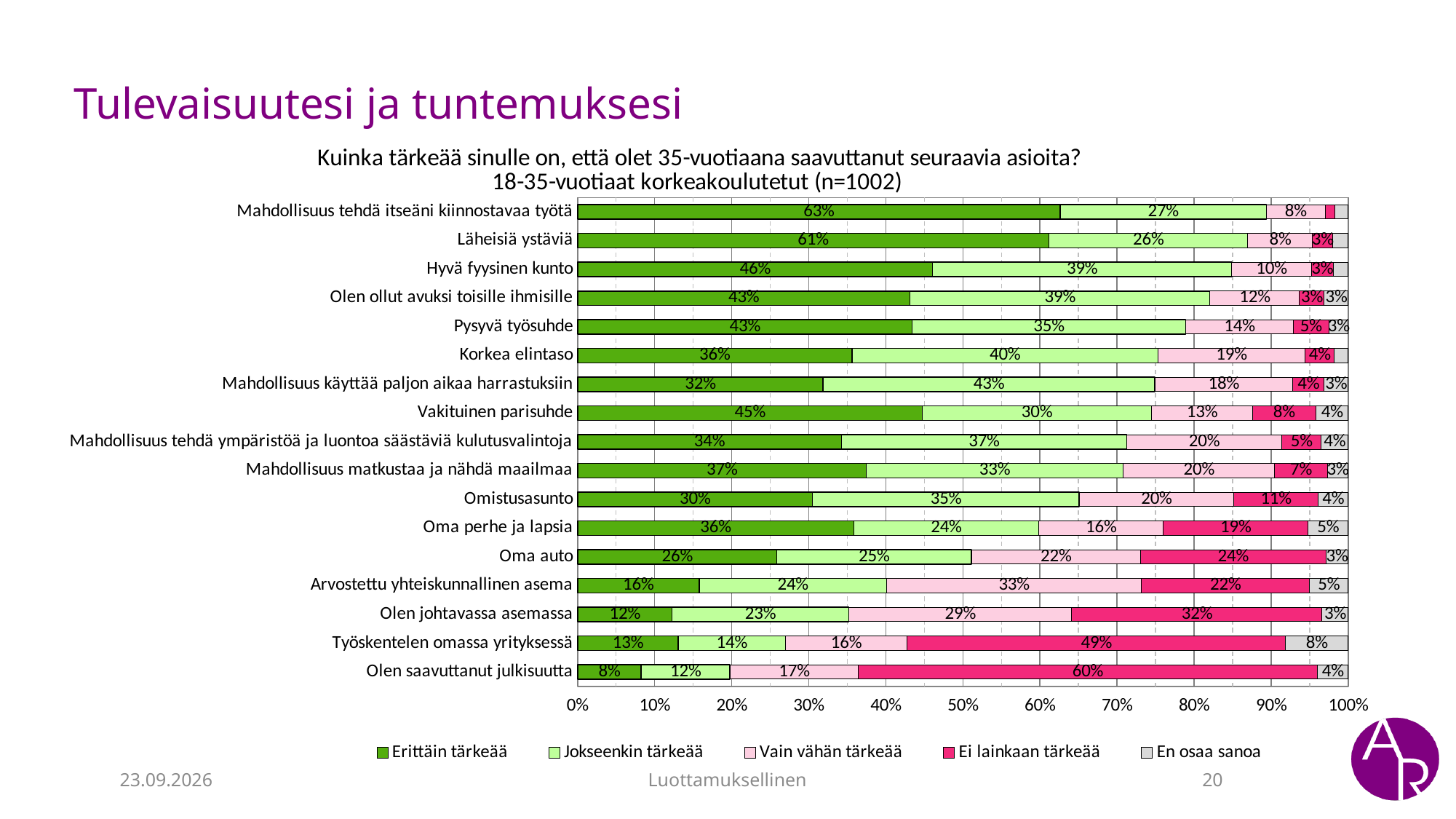
What is the sample size (n) stated in the chart title? n=1002 What is the 'En osaa sanoa' value for 'Työskentelen omassa yrityksessä'? 8% What is the 'Erittäin tärkeää' value for 'Mahdollisuus tehdä itseäni kiinnostavaa työtä'? 63% Which has the larger 'Jokseenkin tärkeää' value: 'Korkea elintaso' or 'Mahdollisuus käyttää paljon aikaa harrastuksiin'? Mahdollisuus käyttää paljon aikaa harrastuksiin Which category has the lowest 'Erittäin tärkeää' share? Olen saavuttanut julkisuutta Which category has the highest 'Erittäin tärkeää' share? Mahdollisuus tehdä itseäni kiinnostavaa työtä What is the 'Ei lainkaan tärkeää' value for 'Olen saavuttanut julkisuutta'? 60% What is the 'Vain vähän tärkeää' value for 'Arvostettu yhteiskunnallinen asema'? 33% What kind of chart is shown on the slide? Stacked bar chart How many series does the legend list? 5 How many categories (statements) are plotted in the chart? 17 What is the difference in 'Erittäin tärkeää' between 'Mahdollisuus tehdä itseäni kiinnostavaa työtä' and 'Läheisiä ystäviä'? 2 percentage points